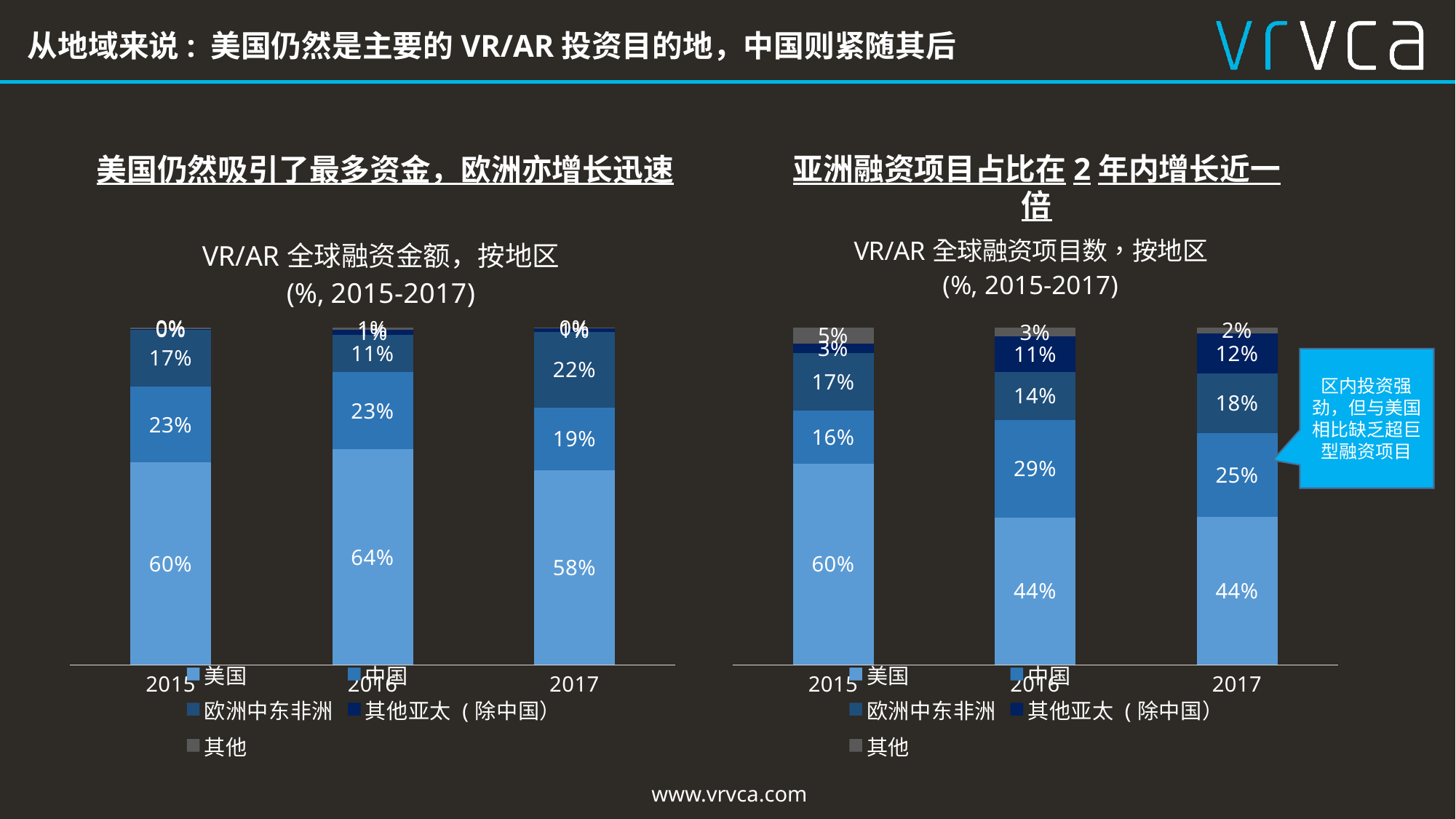
In the left chart (VR/AR 全球融资金额，按地区), what is the value for 美国 in 2016? 64% How many series does the legend of the left chart (VR/AR 全球融资金额，按地区) list? 5 In the right chart (VR/AR 全球融资项目数，按地区), what is the value for 中国 in 2016? 29% In the right chart (VR/AR 全球融资项目数，按地区), what is the difference between the 美国 value in 2015 and in 2017? 16% In the left chart (VR/AR 全球融资金额，按地区), which year has the highest value for 美国? 2016 In the right chart (VR/AR 全球融资项目数，按地区), does the value for 其他亚太（除中国）rise or fall from 2015 to 2017? Rise In the left chart (VR/AR 全球融资金额，按地区), what is the value for 中国 in 2017? 19% How many years are shown on the x axis of the right chart (VR/AR 全球融资项目数，按地区)? 3 In the right chart (VR/AR 全球融资项目数，按地区), what is the value for 其他亚太（除中国）in 2017? 12% In the right chart (VR/AR 全球融资项目数，按地区), which year has the lowest value for 其他? 2017 What kind of chart is the right chart (VR/AR 全球融资项目数，按地区)? Stacked bar chart In the left chart (VR/AR 全球融资金额，按地区), which is larger in 2017: the value for 中国 or the value for 欧洲中东非洲? 欧洲中东非洲